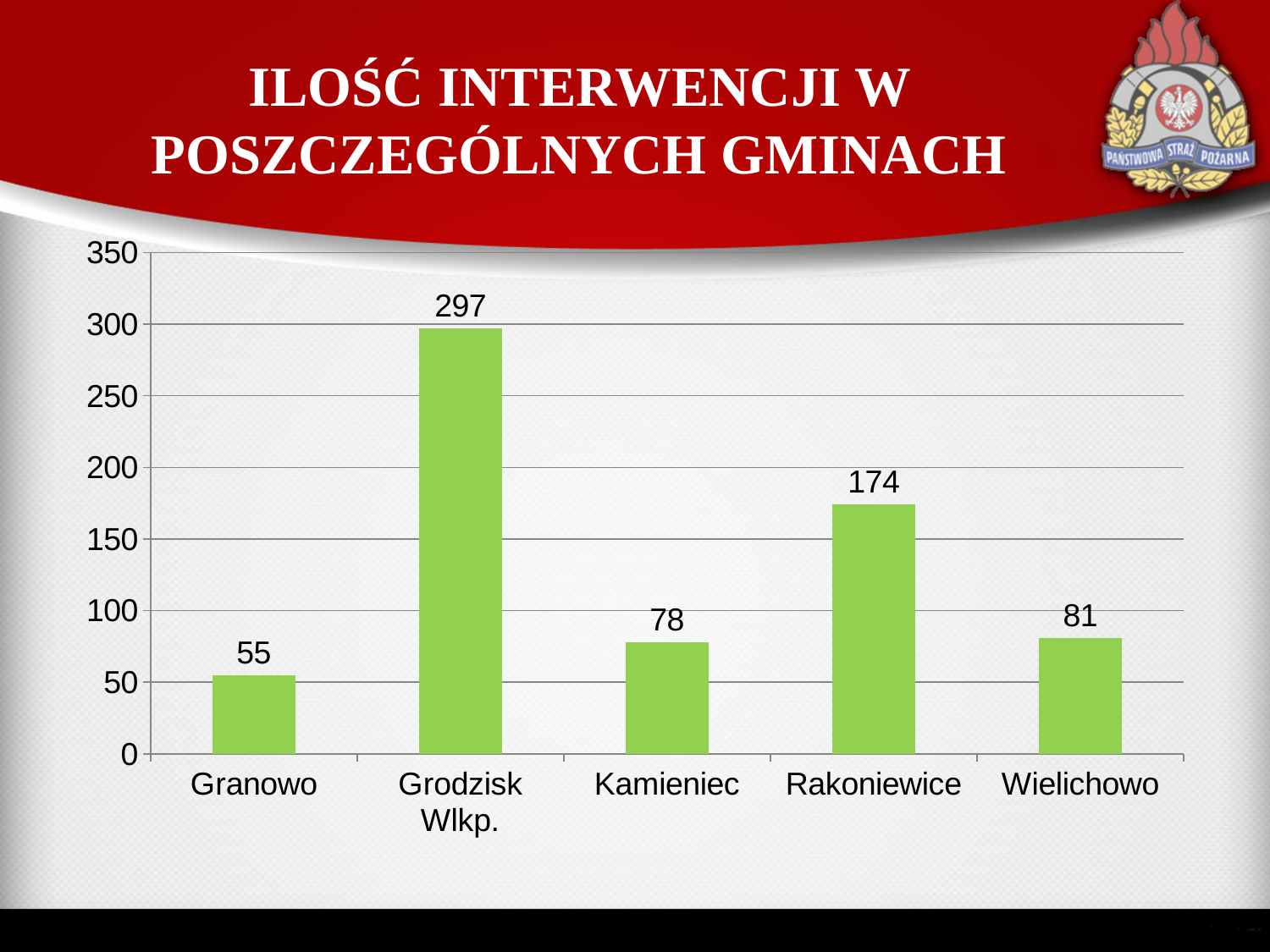
What is the value for Grodzisk Wlkp.? 297 How many gminas are shown on the chart? 5 What is the difference between the values for Grodzisk Wlkp. and Rakoniewice? 123 What is the value for Granowo? 55 What is the value for Wielichowo? 81 Which is larger, the value for Kamieniec or the value for Wielichowo? Wielichowo Which gmina has the highest number of interventions? Grodzisk Wlkp. Which gmina has the lowest number of interventions? Granowo What is the value for Rakoniewice? 174 Is the value for Rakoniewice greater or less than 150? greater What kind of chart is shown on the slide? bar chart What is the value for Kamieniec? 78